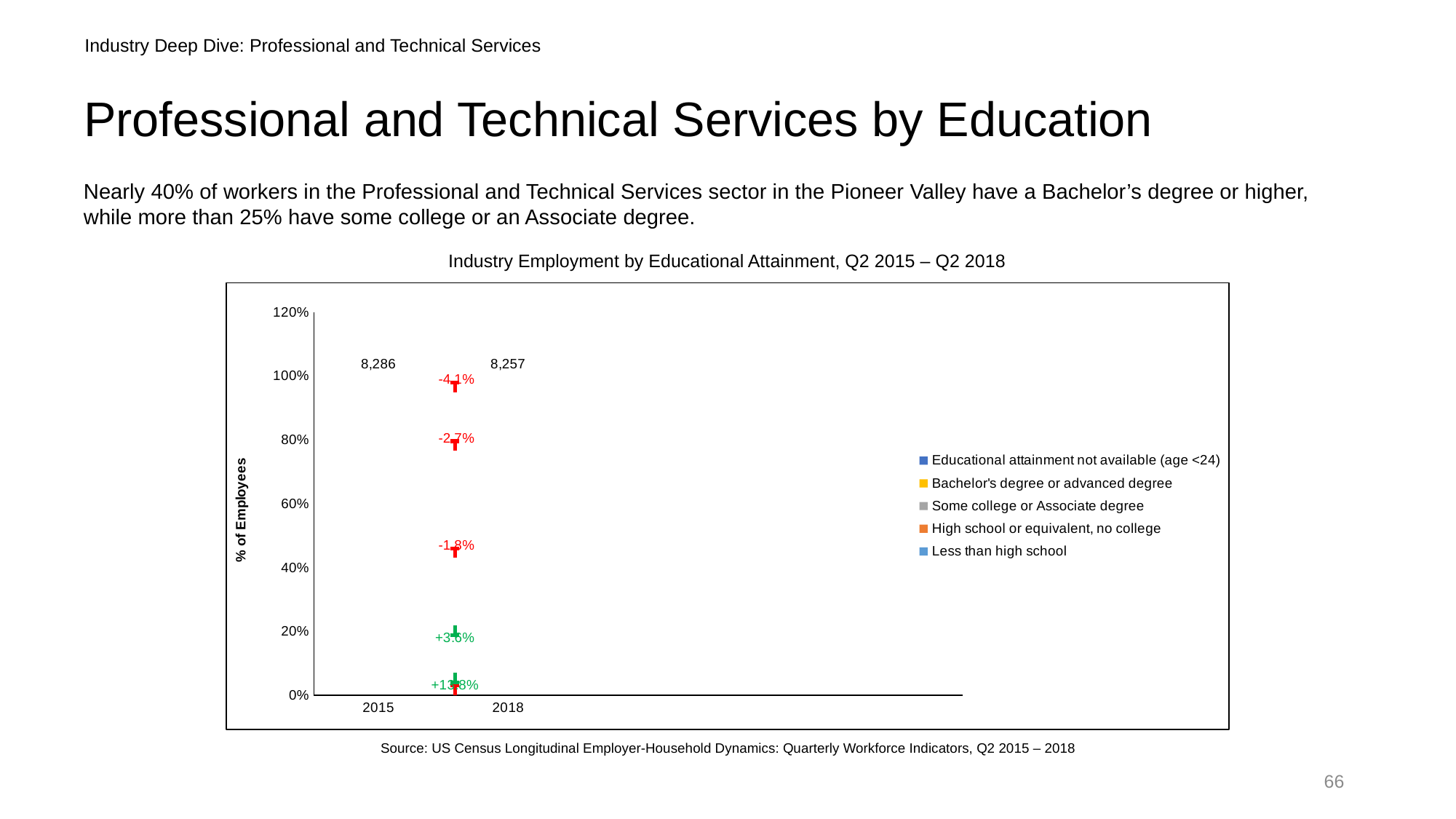
What is the topmost percentage-change label printed in red on the chart? -4.1% What is the highest value shown on the y axis? 120% What total employment figure is printed above the 2018 column? 8,257 What is the difference between the total employment figures printed for 2015 and 2018? 29 What total employment figure is printed above the 2015 column? 8,286 How many series does the chart's legend list? 5 What is the label of the y axis? % of Employees Which year has the larger total employment figure printed on the chart, 2015 or 2018? 2015 What percentage-change label is printed in red just below the 80% gridline? -2.7% What is the title of the chart? Industry Employment by Educational Attainment, Q2 2015 – Q2 2018 What percentage-change label is printed in green near the 20% gridline? +3.6% How many years are shown on the x axis of the chart? 2